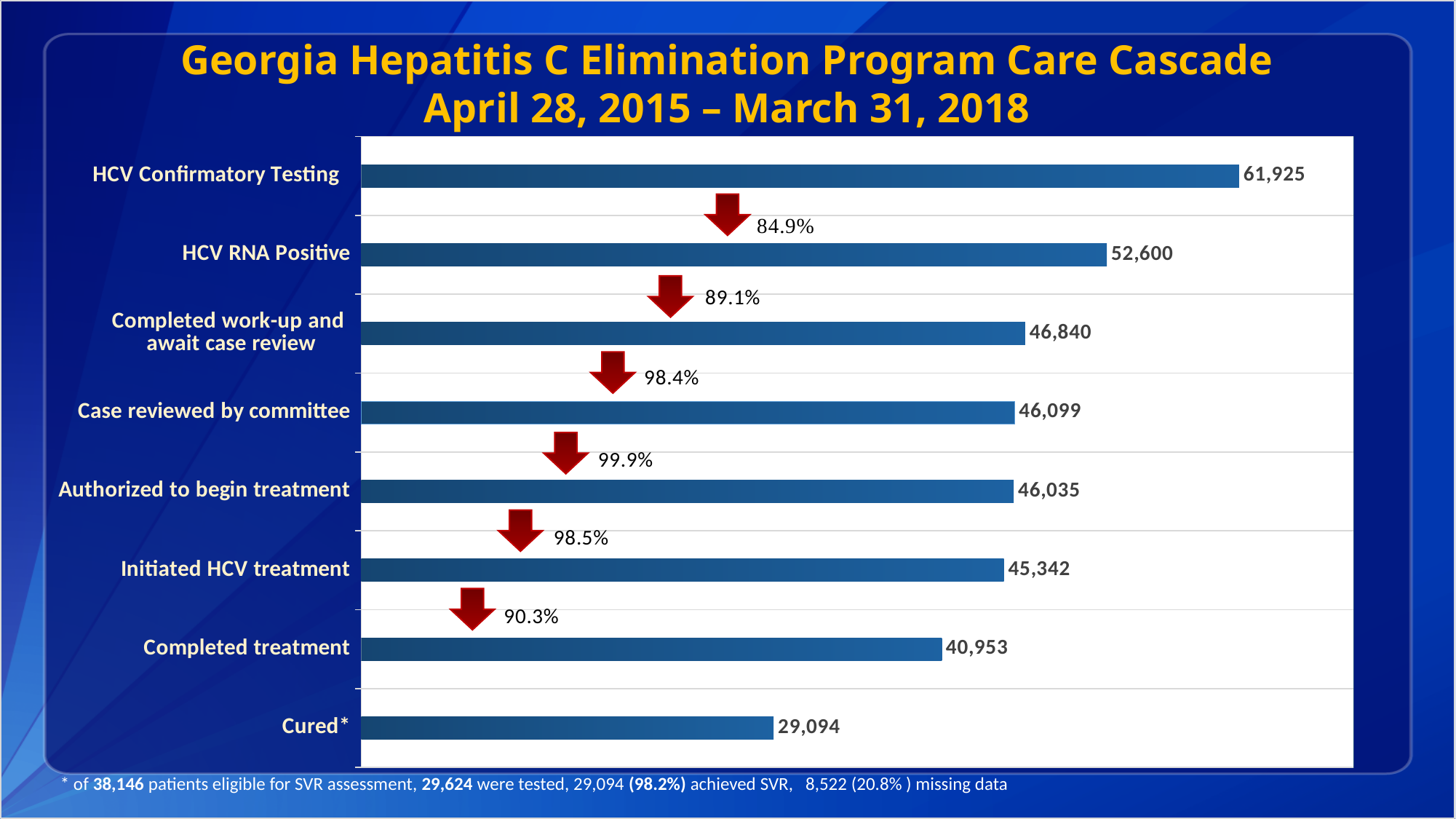
Which category has the lowest value? Cured* What is the value for HCV Confirmatory Testing? 61,925 Which category has the highest value? HCV Confirmatory Testing What kind of chart is shown on the slide? Bar chart Which is larger, Case reviewed by committee or Completed work-up and await case review? Completed work-up and await case review What is the value for Initiated HCV treatment? 45,342 What is the value for Completed treatment? 40,953 How many categories are shown in the chart? 8 What is the difference between HCV Confirmatory Testing and HCV RNA Positive? 9,325 What is the title of the chart? Georgia Hepatitis C Elimination Program Care Cascade April 28, 2015 – March 31, 2018 What percentage is shown on the arrow between HCV RNA Positive and Completed work-up and await case review? 89.1% What is the difference between Completed treatment and Cured*? 11,859